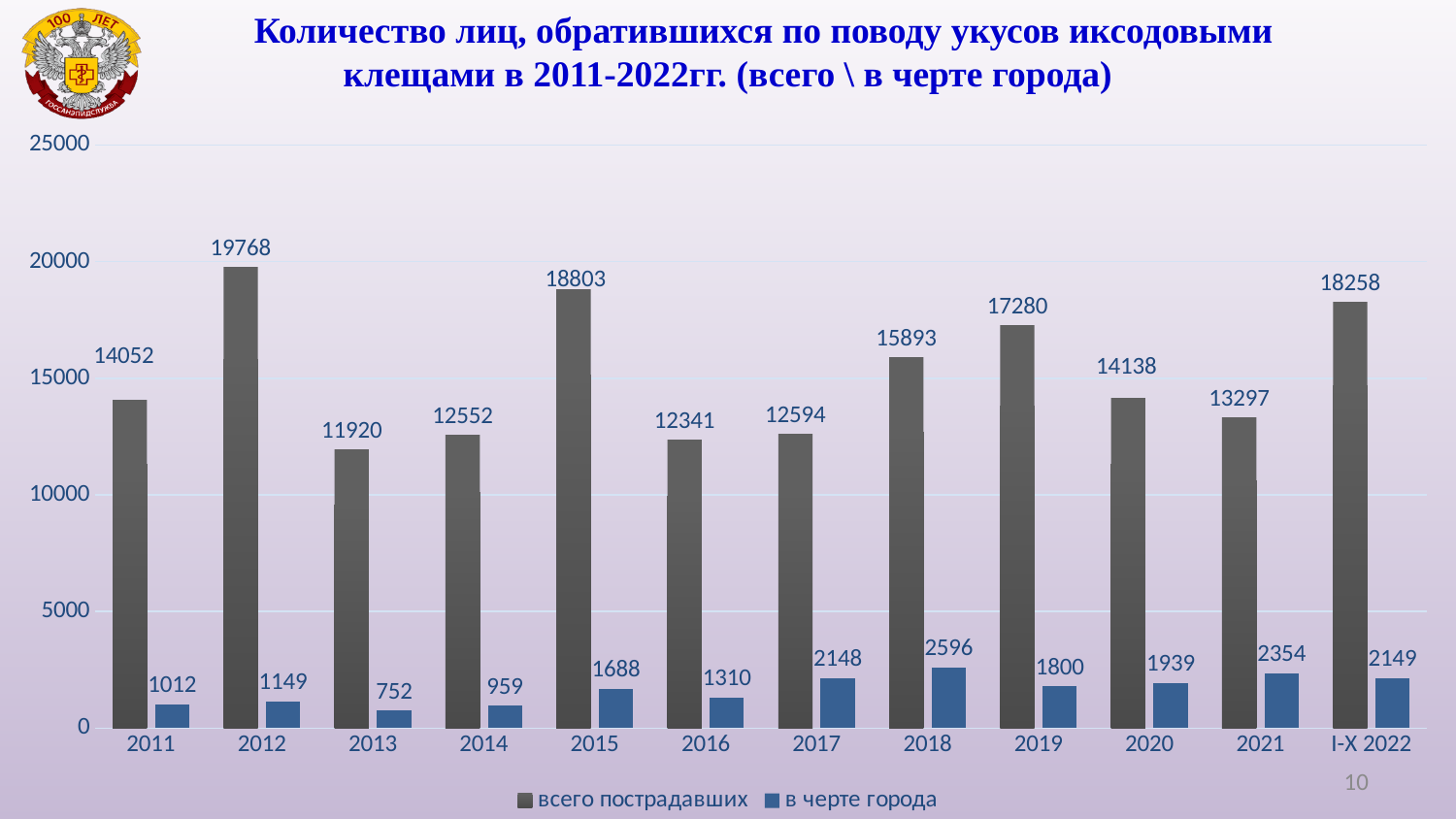
How many series does the legend list? 2 What kind of chart is shown on the slide? bar chart What is the value for 'в черте города' in 2018? 2596 Which is larger: the 'в черте города' value for 2021 or for 2019? 2021 How many categories are shown on the x axis? 12 What is the value for 'всего пострадавших' in I-X 2022? 18258 Which series is shown in blue? в черте города Which year has the highest value for 'всего пострадавших'? 2012 What is the difference between the 'всего пострадавших' values for 2015 and 2016? 6462 What is the value for 'всего пострадавших' in 2012? 19768 Is the value for 'всего пострадавших' in 2019 greater or less than 15000? greater Which category has the lowest value for 'в черте города'? 2013